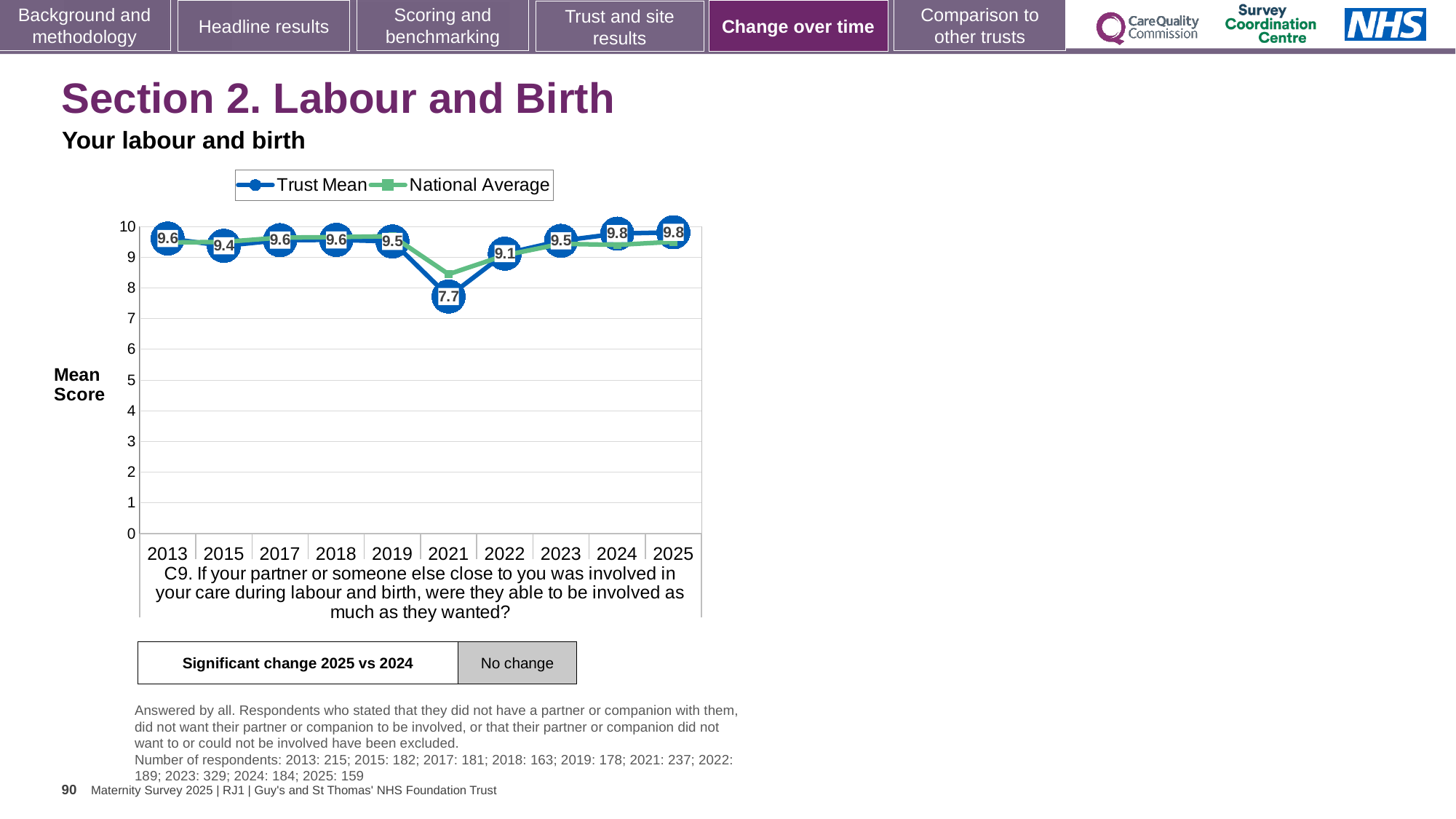
What kind of chart is shown on the slide? line chart Does the Trust Mean rise or fall from 2021 to 2024? rise What is the Trust Mean value for 2021? 7.7 Which is larger, the Trust Mean for 2022 or for 2023? 2023 How many series does the legend list? 2 What is the Trust Mean value for 2015? 9.4 In which year is the Trust Mean lowest? 2021 What is the Trust Mean value for 2025? 9.8 How many survey years are shown on the x axis? 10 What is the highest Trust Mean value shown on the chart? 9.8 What is the difference between the Trust Mean in 2025 and in 2021? 2.1 Is the National Average value for 2021 greater or less than 9? less